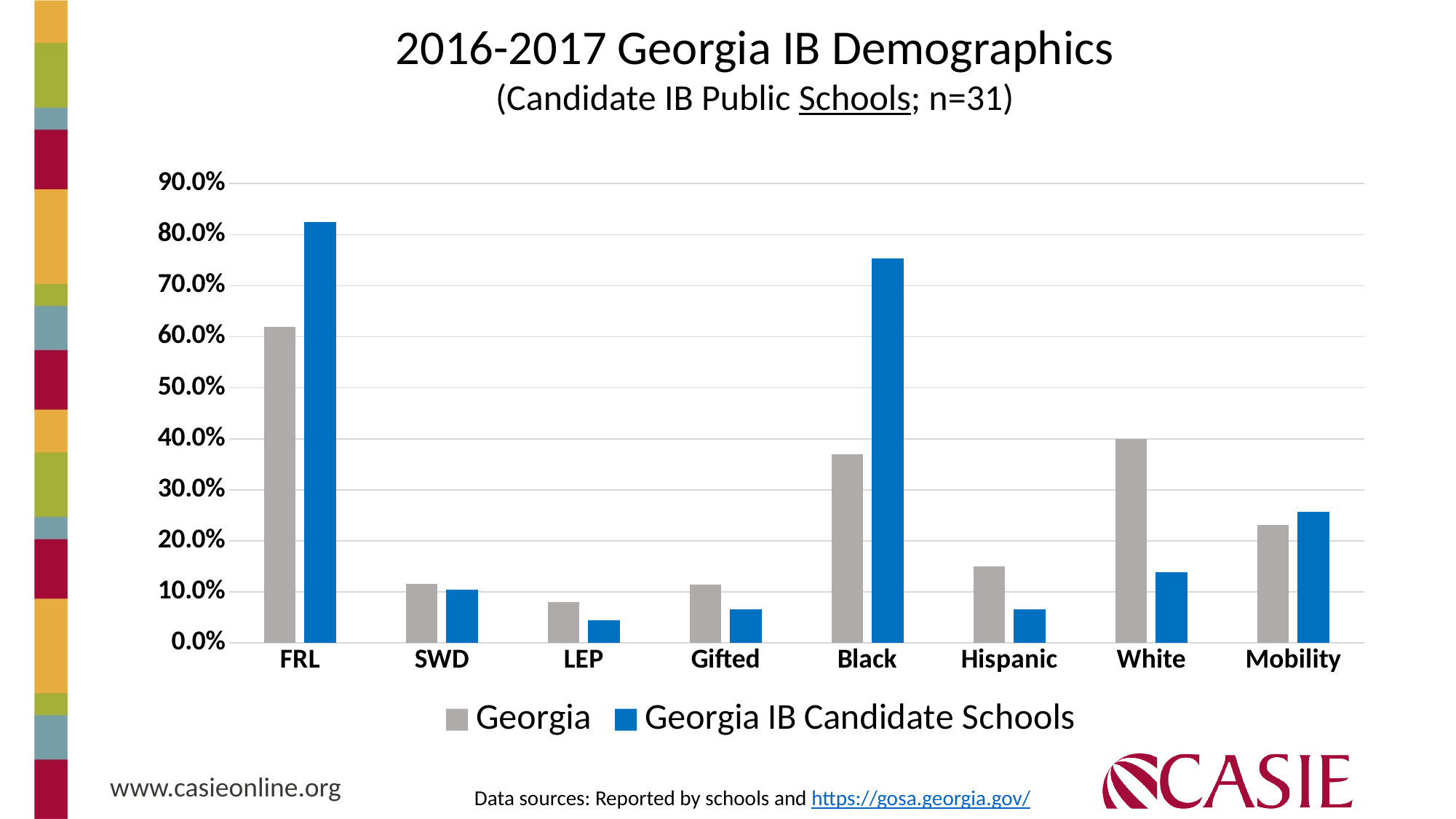
Which category has the highest value for Georgia IB Candidate Schools? FRL How many series does the legend list? 2 For Black, which series has the larger value, Georgia or Georgia IB Candidate Schools? Georgia IB Candidate Schools How many categories are shown on the x axis? 8 For White, which series has the larger value, Georgia or Georgia IB Candidate Schools? Georgia Is the value for FRL in the Georgia IB Candidate Schools series greater or less than 80.0%? greater What kind of chart is shown on the slide? bar chart Is the value for Black in the Georgia series greater or less than 40.0%? less Which category has the highest value for the Georgia series? FRL What is the title of the chart? 2016-2017 Georgia IB Demographics (Candidate IB Public Schools; n=31) Which category has the lowest value for Georgia IB Candidate Schools? LEP Is the value for LEP in the Georgia IB Candidate Schools series greater or less than 10.0%? less